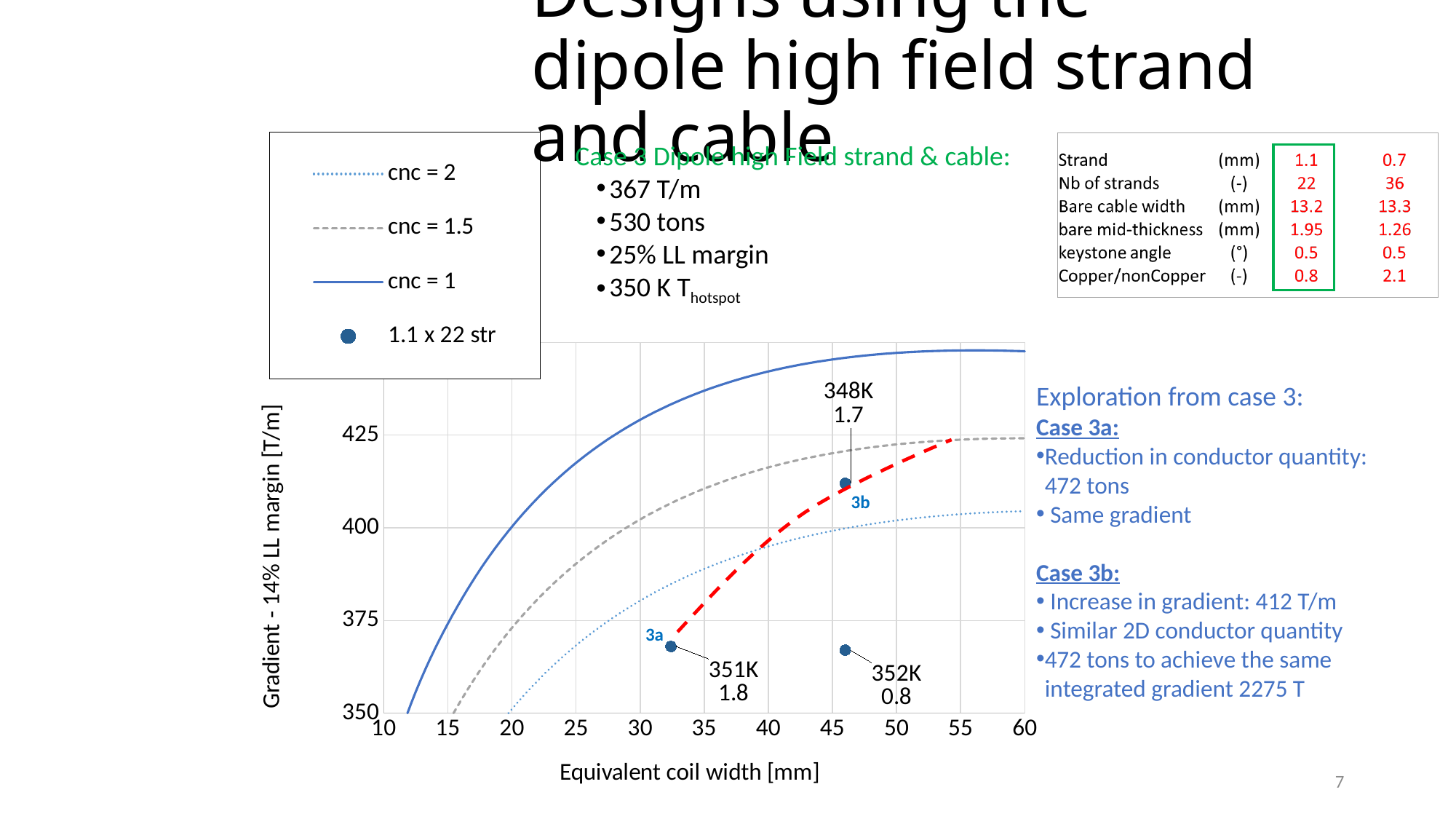
Which curve is the lowest at an equivalent coil width of 40 mm? cnc = 2 Is the gradient of point 3a greater or less than 375? less Which curve is the highest at an equivalent coil width of 40 mm? cnc = 1 What is the title of the x axis of the chart? Equivalent coil width [mm] Is the value of the cnc = 2 curve at an equivalent coil width of 30 mm greater or less than 400? less How many entries does the chart legend list? 4 Does the cnc = 1 curve rise or fall as the equivalent coil width increases from 15 mm to 40 mm? rise What type of chart is shown on the slide? line chart What is the title of the y axis of the chart? Gradient - 14% LL margin [T/m] Which point has the higher gradient, 3a or 3b? 3b Is the value of the cnc = 1 curve at an equivalent coil width of 30 mm greater or less than 400? greater What data label is attached to point 3b? 348K 1.7